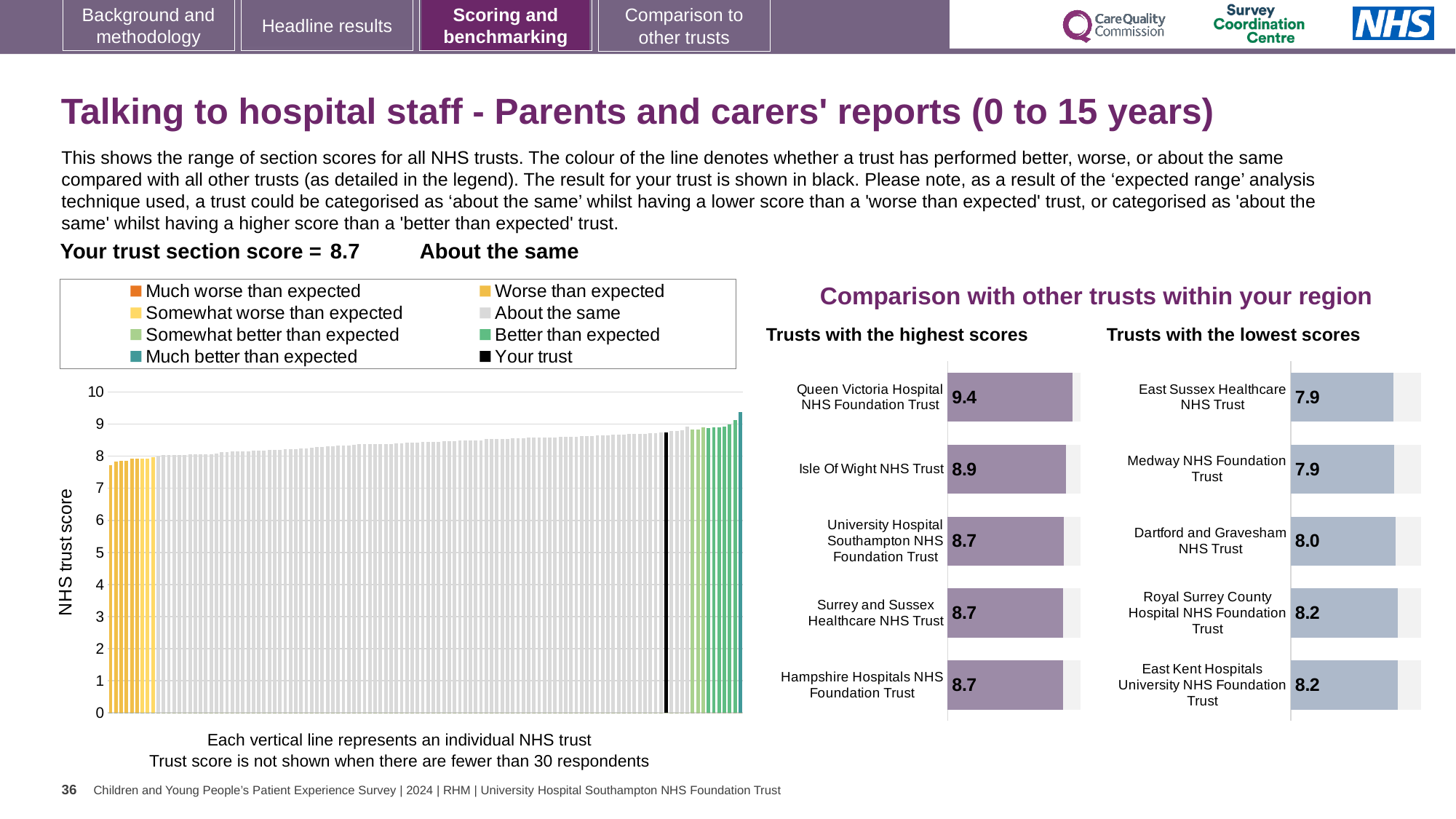
In the 'Trusts with the highest scores' chart, what is the score for Queen Victoria Hospital NHS Foundation Trust? 9.4 In the 'Trusts with the highest scores' chart, what is the difference between the scores of Queen Victoria Hospital NHS Foundation Trust and Isle Of Wight NHS Trust? 0.5 In the 'Trusts with the lowest scores' chart, what is the score for East Kent Hospitals University NHS Foundation Trust? 8.2 In the main 'NHS trust score' chart, is the value of the black 'Your trust' bar greater or less than 8? greater How many entries does the legend of the main 'NHS trust score' chart list? 8 In the 'Trusts with the lowest scores' chart, which has the larger score: Royal Surrey County Hospital NHS Foundation Trust or Medway NHS Foundation Trust? Royal Surrey County Hospital NHS Foundation Trust In the 'Trusts with the highest scores' chart, which trust has the highest score? Queen Victoria Hospital NHS Foundation Trust In the 'Trusts with the lowest scores' chart, what is the score for Dartford and Gravesham NHS Trust? 8.0 How many trusts are listed in the 'Trusts with the highest scores' chart? 5 In the 'Trusts with the highest scores' chart, what is the score for Isle Of Wight NHS Trust? 8.9 What is the title of the right-hand section containing the highest and lowest scores charts? Comparison with other trusts within your region What kind of chart is the main 'NHS trust score' chart on the left of the slide? bar chart